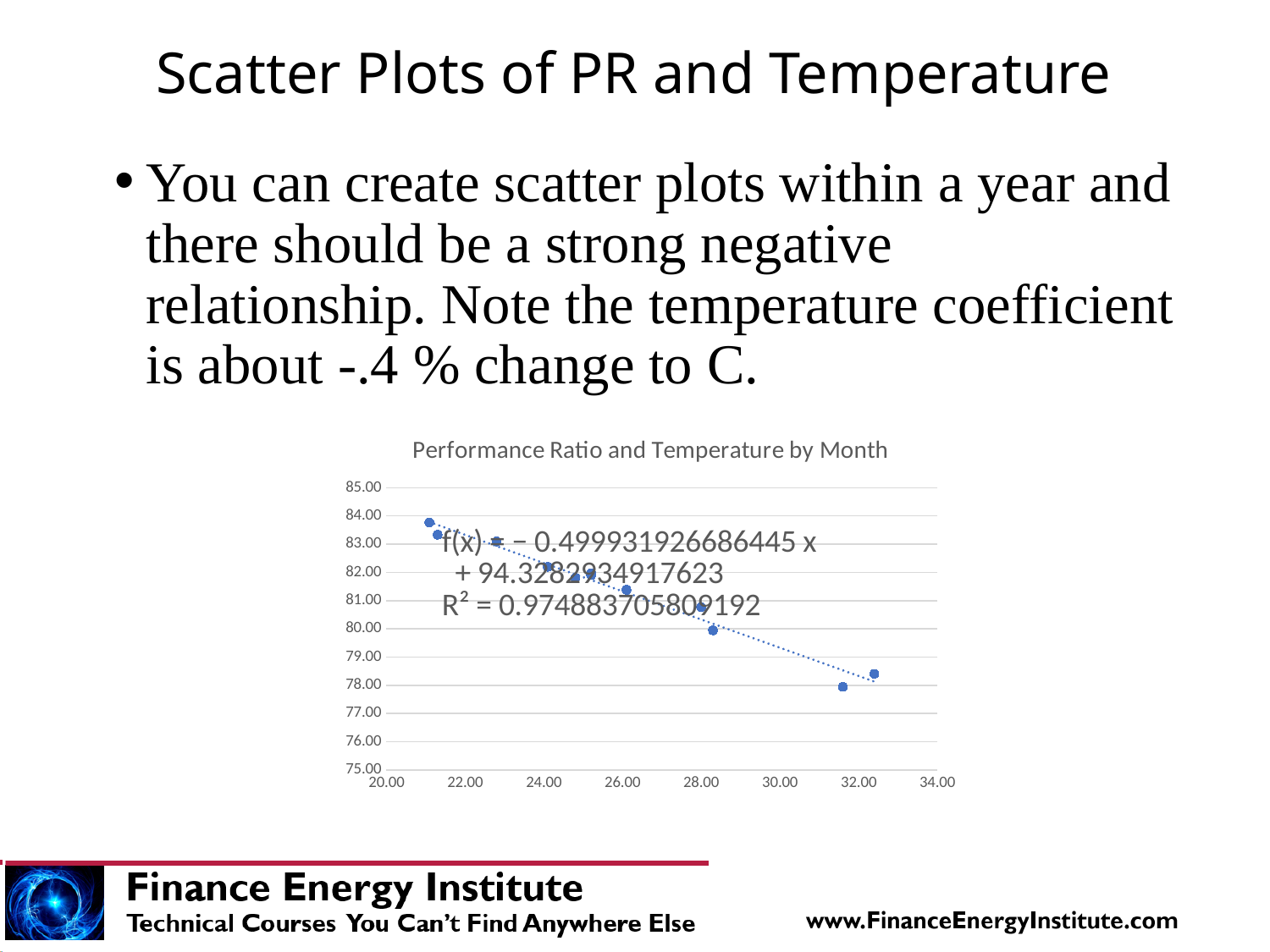
Is the value of the point near 26.00 on the x axis greater or less than 80.00? greater Is the value of the point near 28.00 on the x axis greater or less than 82.00? less Is the value of the rightmost point (near 32.00 on the x axis) greater or less than 79.00? less What R² value is printed on the chart? R² = 0.974883705809192 As temperature increases along the x axis, do the performance ratio values rise or fall? fall What is the title of the chart? Performance Ratio and Temperature by Month What kind of chart is shown on the slide? scatter plot Which has the higher performance ratio: the point near 21.00 or the point near 32.00 on the x axis? the point near 21.00